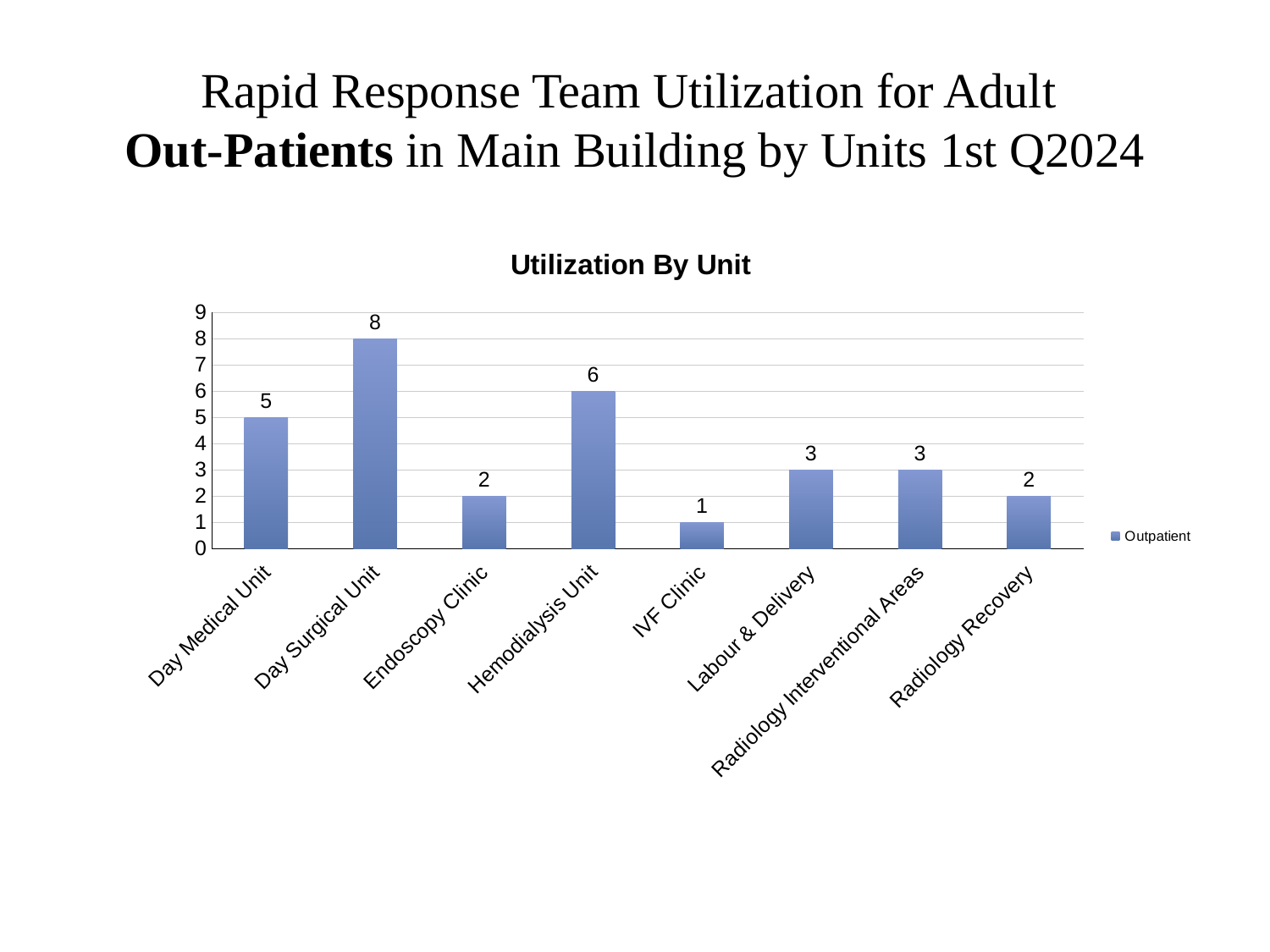
Which unit has the highest value? Day Surgical Unit How many units are shown on the x axis? 8 What is the value for Hemodialysis Unit? 6 Which unit has the lowest value? IVF Clinic What is the value for IVF Clinic? 1 How many series does the legend list? 1 Which is larger, the value for Hemodialysis Unit or the value for Labour & Delivery? Hemodialysis Unit Is the value for Day Medical Unit greater or less than 4? greater What is the title of the chart? Utilization By Unit What is the difference between the values for Day Surgical Unit and Day Medical Unit? 3 What kind of chart is shown? bar chart What is the value for Day Surgical Unit? 8